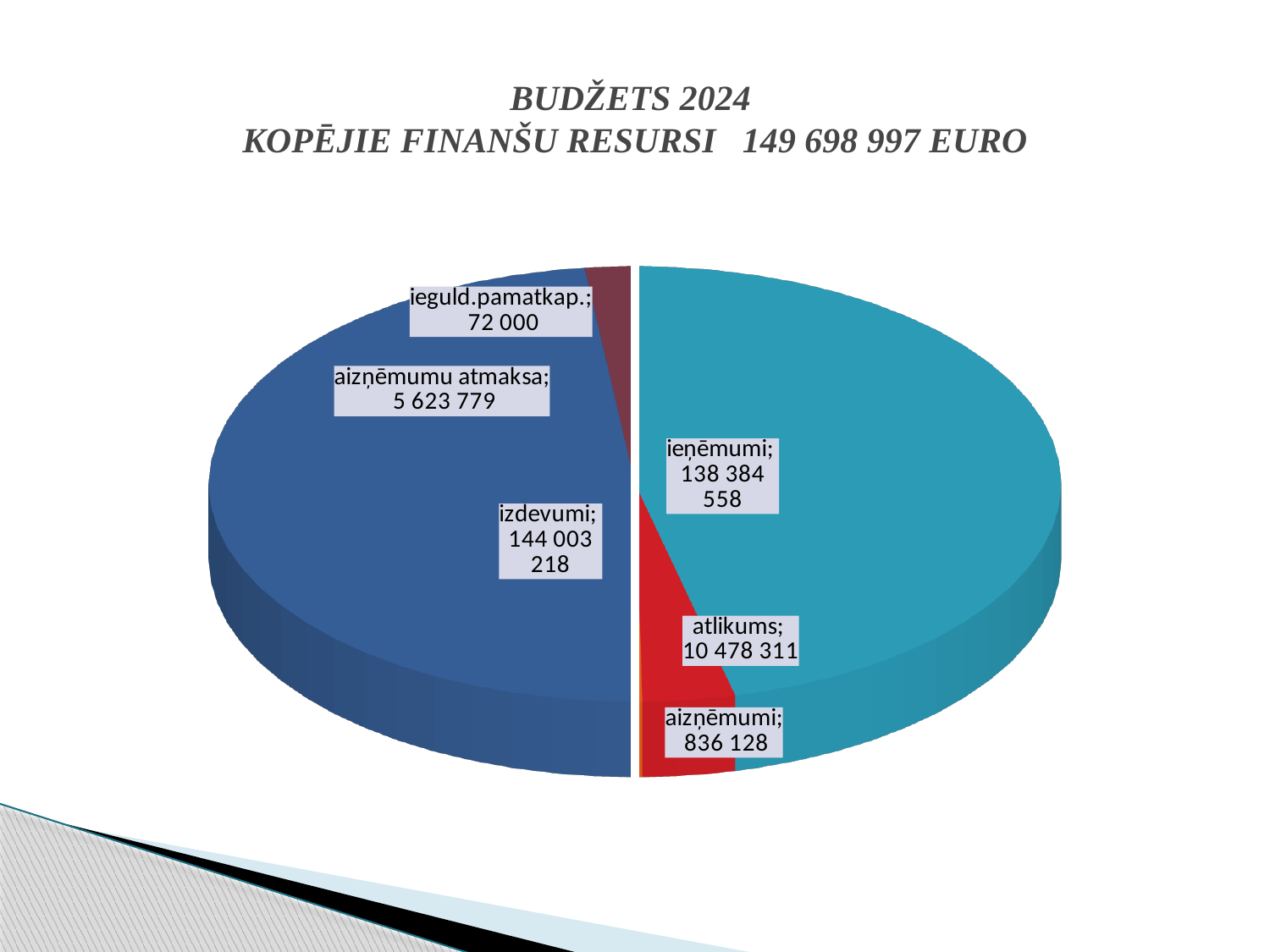
What is the value for izdevumi? 144 003 218 What is the difference between izdevumi and ieņēmumi? 5 618 660 Which slice has the largest value? izdevumi Which is larger, atlikums or aizņēmumu atmaksa? atlikums What is the value for aizņēmumu atmaksa? 5 623 779 What total amount of financial resources is stated in the slide title? 149 698 997 EURO What is the value for ieņēmumi? 138 384 558 What kind of chart is shown on the slide? pie chart What is the difference between atlikums and aizņēmumi? 9 642 183 How many slices does the pie chart have? 6 What is the value for atlikums? 10 478 311 Which slice has the smallest value? ieguld.pamatkap.